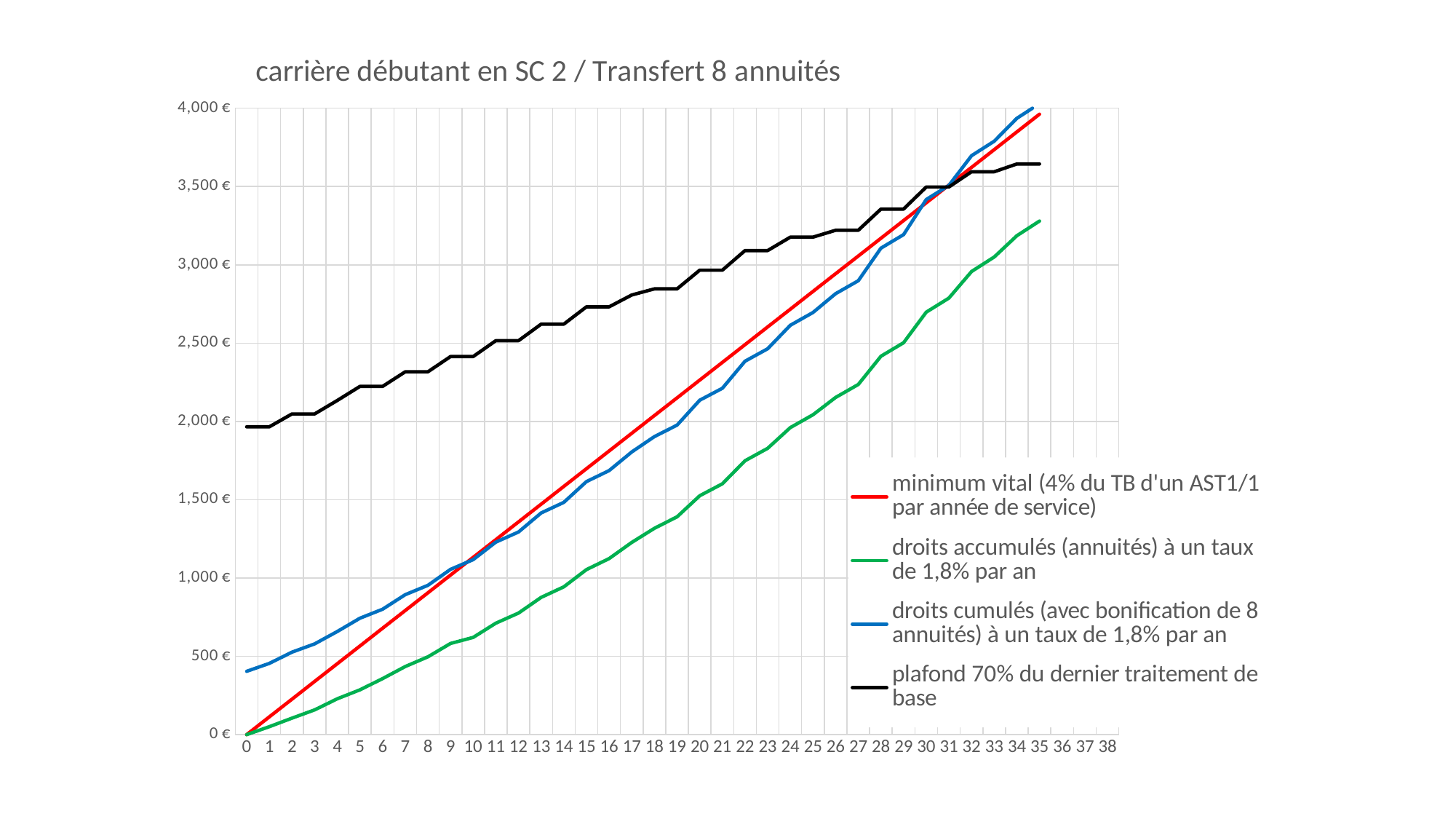
What is the title of the chart? carrière débutant en SC 2 / Transfert 8 annuités Which series has the lowest value at x = 35? droits accumulés (annuités) à un taux de 1,8% par an Does the 'droits accumulés (annuités) à un taux de 1,8% par an' series rise or fall as the x axis increases? rise Is the value of the 'droits cumulés (avec bonification de 8 annuités)' series at x = 0 greater or less than 500 €? less Which colour is used for the 'plafond 70% du dernier traitement de base' series? black At x = 10, which is higher: the 'plafond 70% du dernier traitement de base' series or the 'minimum vital' series? plafond 70% du dernier traitement de base Is the value of the 'droits accumulés (annuités) à un taux de 1,8% par an' series at x = 35 greater or less than 3,000 €? greater Is the value of the 'plafond 70% du dernier traitement de base' series at x = 35 greater or less than 3,500 €? greater At x = 20, which is higher: the 'droits cumulés (avec bonification de 8 annuités)' series or the 'droits accumulés (annuités)' series? droits cumulés (avec bonification de 8 annuités) What kind of chart is shown on the slide? line chart How many series does the legend list? 4 What is the value of the 'minimum vital' series at x = 0? 0 €